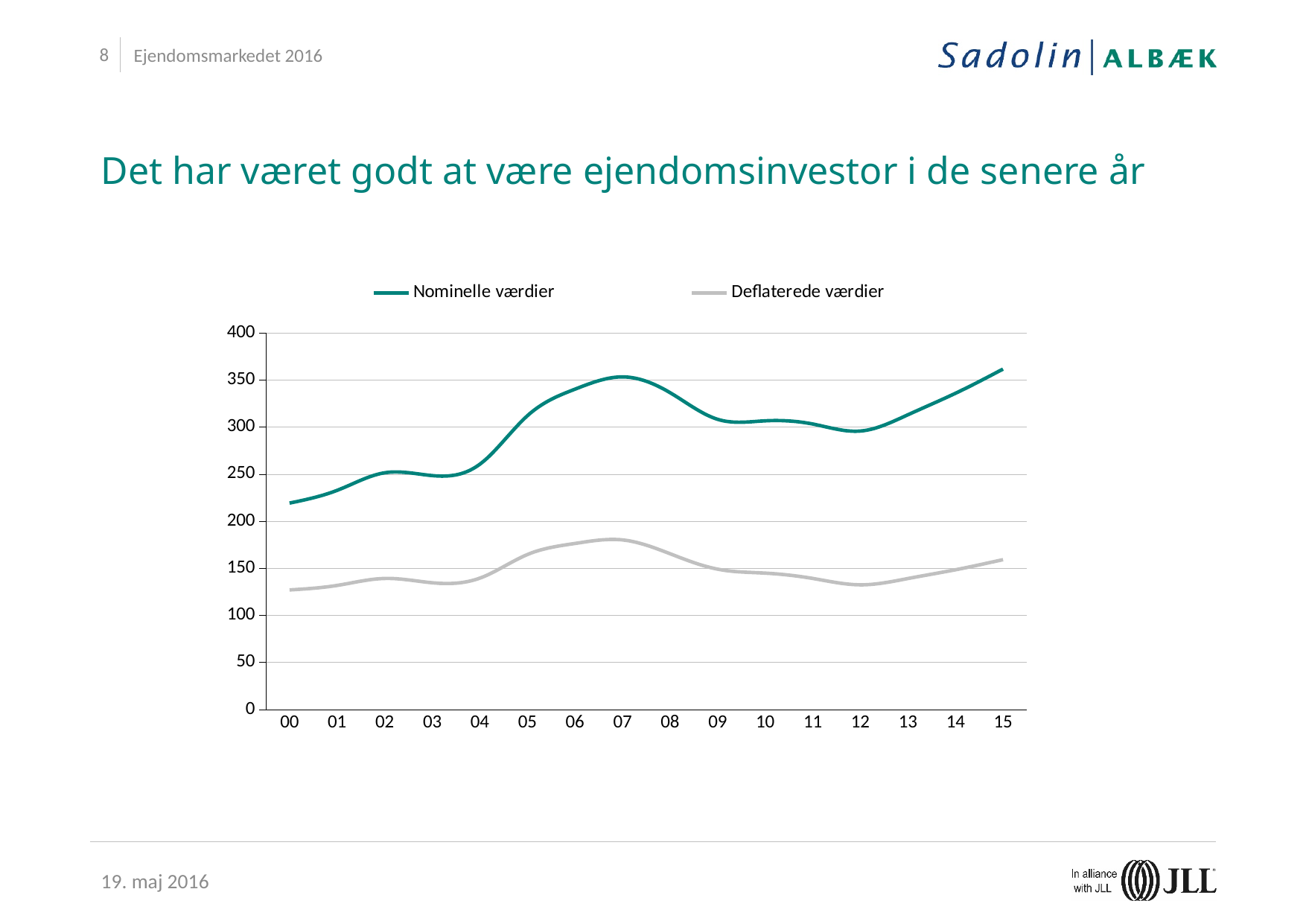
Which series has the higher value in 10, Nominelle værdier or Deflaterede værdier? Nominelle værdier Is the value for Deflaterede værdier in 07 greater or less than 150? greater Is the value for Nominelle værdier in 07 greater or less than 300? greater Does Nominelle værdier rise or fall from 12 to 15? rise Is the value for Deflaterede værdier in 12 greater or less than 150? less In which year is Deflaterede værdier at its highest? 07 How many series does the legend list? 2 How many years are shown along the x axis? 16 In which year is Nominelle værdier at its lowest? 00 What kind of chart is shown on the slide? line chart Which series is drawn in green? Nominelle værdier